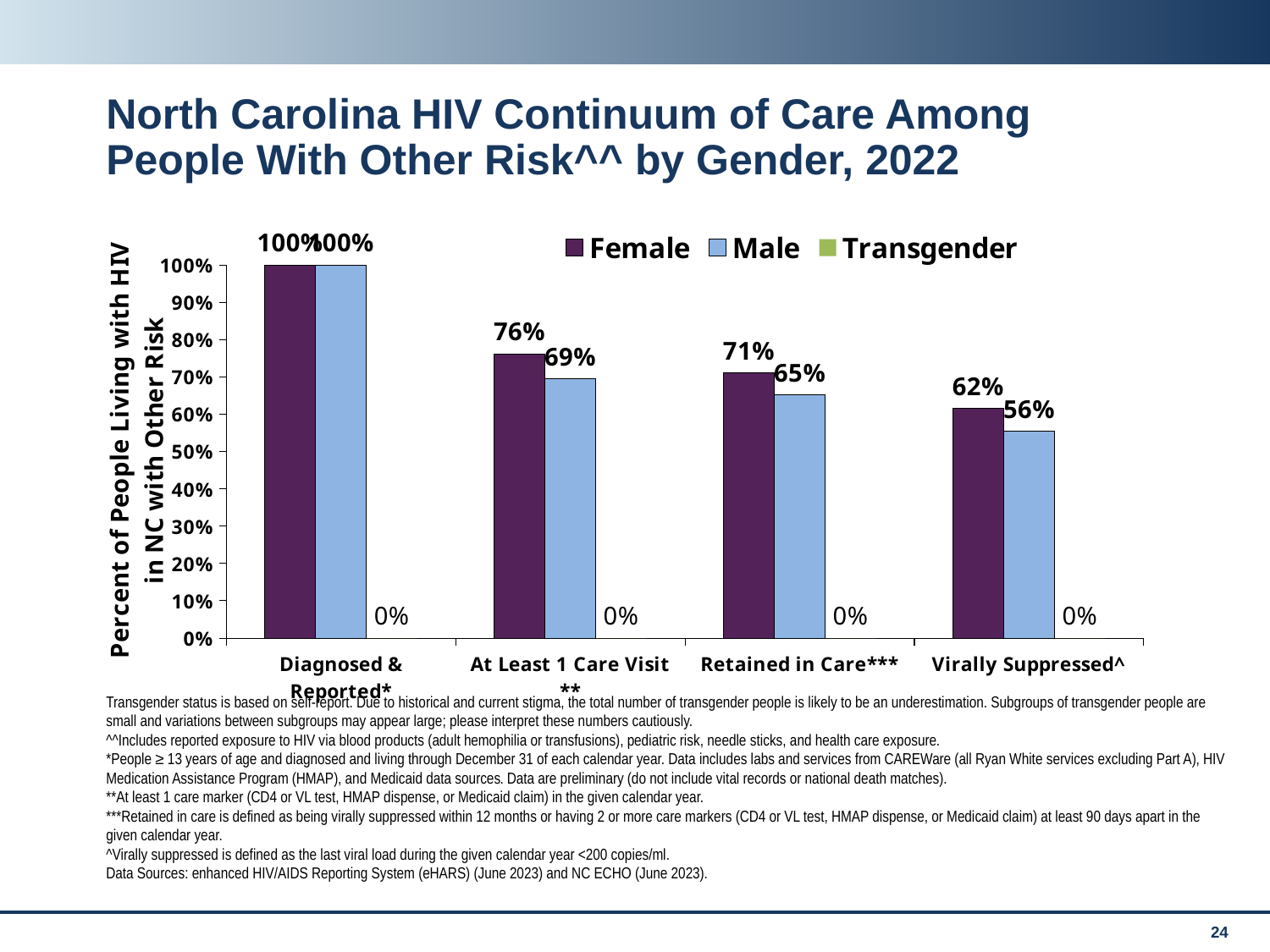
What is the value for Male in the Virally Suppressed^ category? 56% What is the difference between the Female values for Retained in Care*** and Virally Suppressed^? 9% What kind of chart is shown on the slide? Bar chart Which category has the lowest value for the Female series? Virally Suppressed^ How many categories are shown on the x axis? 4 What is the value for Male in the At Least 1 Care Visit** category? 69% What is the value for Transgender in the At Least 1 Care Visit** category? 0% What is the value for Female in the Retained in Care*** category? 71% Do the Male values rise or fall from left to right across the categories? Fall How many series does the legend list? 3 Which is larger in the Retained in Care*** category, the Female value or the Male value? Female What is the difference between the Female and Male values in the At Least 1 Care Visit** category? 7%